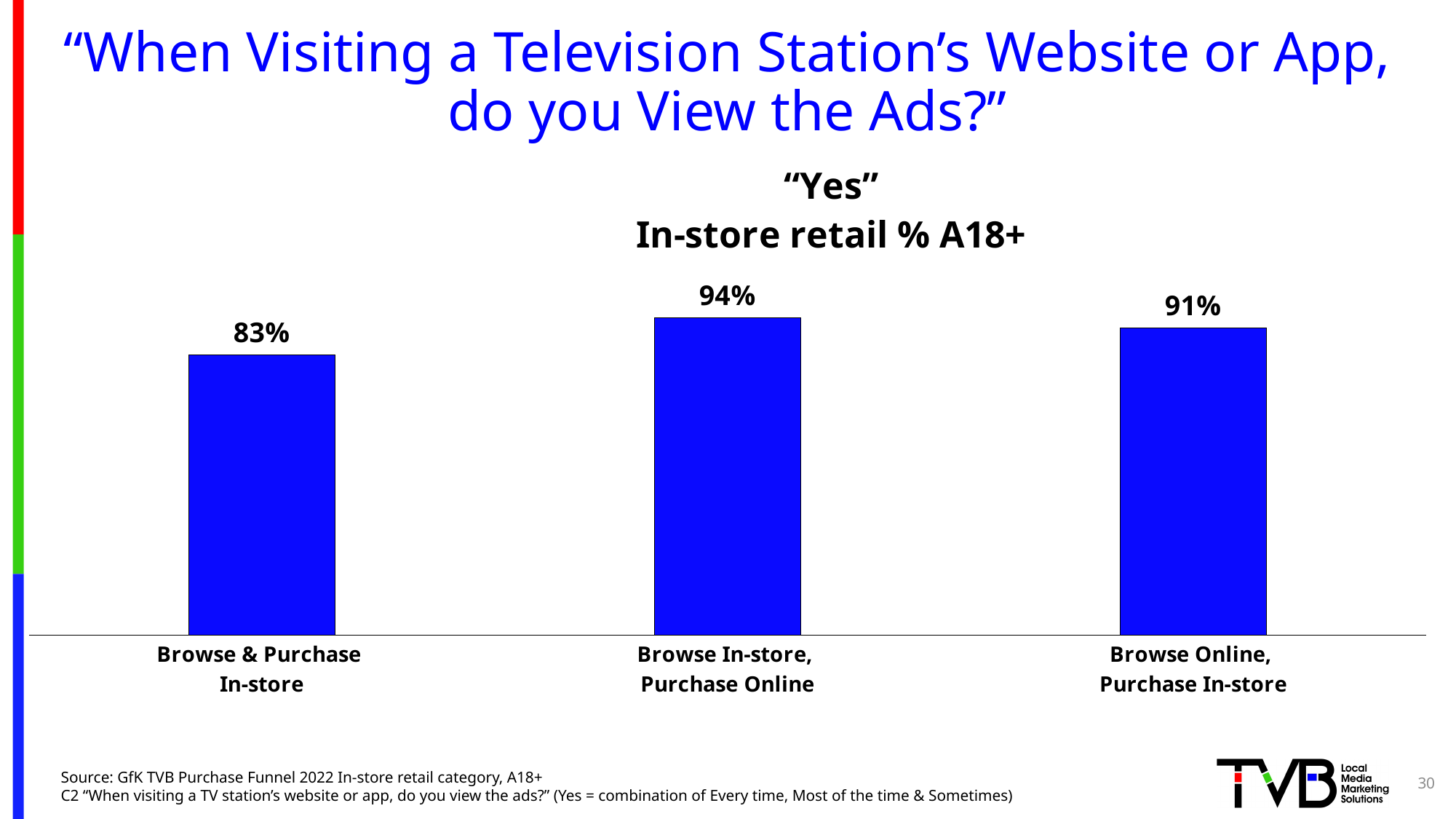
What is the difference between the values for Browse In-store, Purchase Online and Browse Online, Purchase In-store? 3% How many categories are shown in the chart? 3 What is the value for Browse Online, Purchase In-store? 91% Which is larger: the value for Browse Online, Purchase In-store or the value for Browse & Purchase In-store? Browse Online, Purchase In-store What is the title of the chart? "Yes" In-store retail % A18+ What is the value for Browse & Purchase In-store? 83% Which category has the lowest value? Browse & Purchase In-store What colour are the bars in the chart? blue What is the difference between the values for Browse In-store, Purchase Online and Browse & Purchase In-store? 11% What is the value for Browse In-store, Purchase Online? 94% Which category has the highest value? Browse In-store, Purchase Online What kind of chart is shown on the slide? bar chart